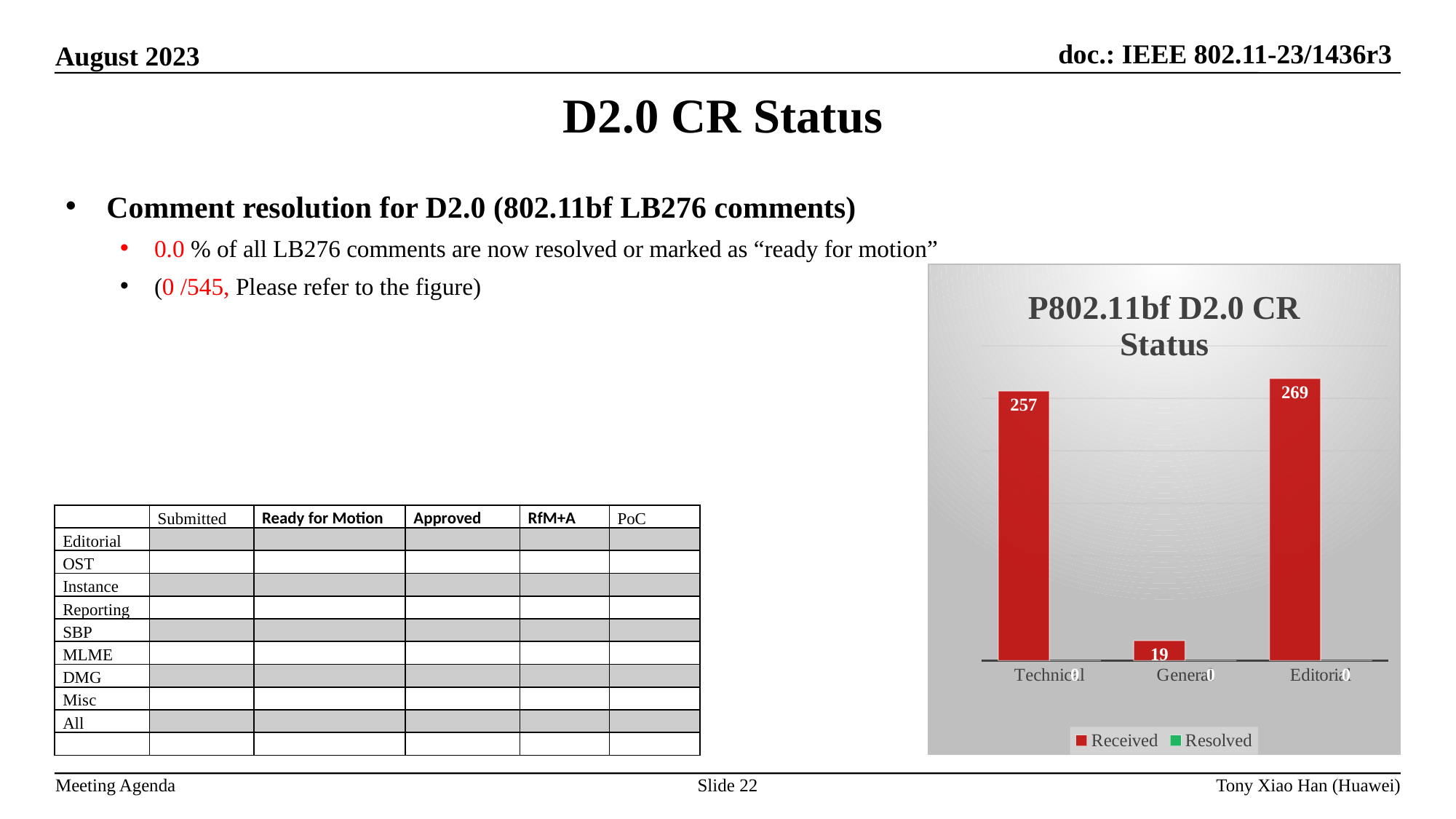
What is the title of the chart? P802.11bf D2.0 CR Status What is the Received value for General? 19 Which is larger, the Received value for Technical or for General? Technical What is the difference between the Received values for Technical and General? 238 What kind of chart is shown? bar chart What is the Received value for Technical? 257 Which category has the lowest Received value? General How many categories are shown on the x axis? 3 What is the difference between the Received values for Editorial and Technical? 12 What is the Received value for Editorial? 269 How many series does the legend list? 2 Which category has the highest Received value? Editorial